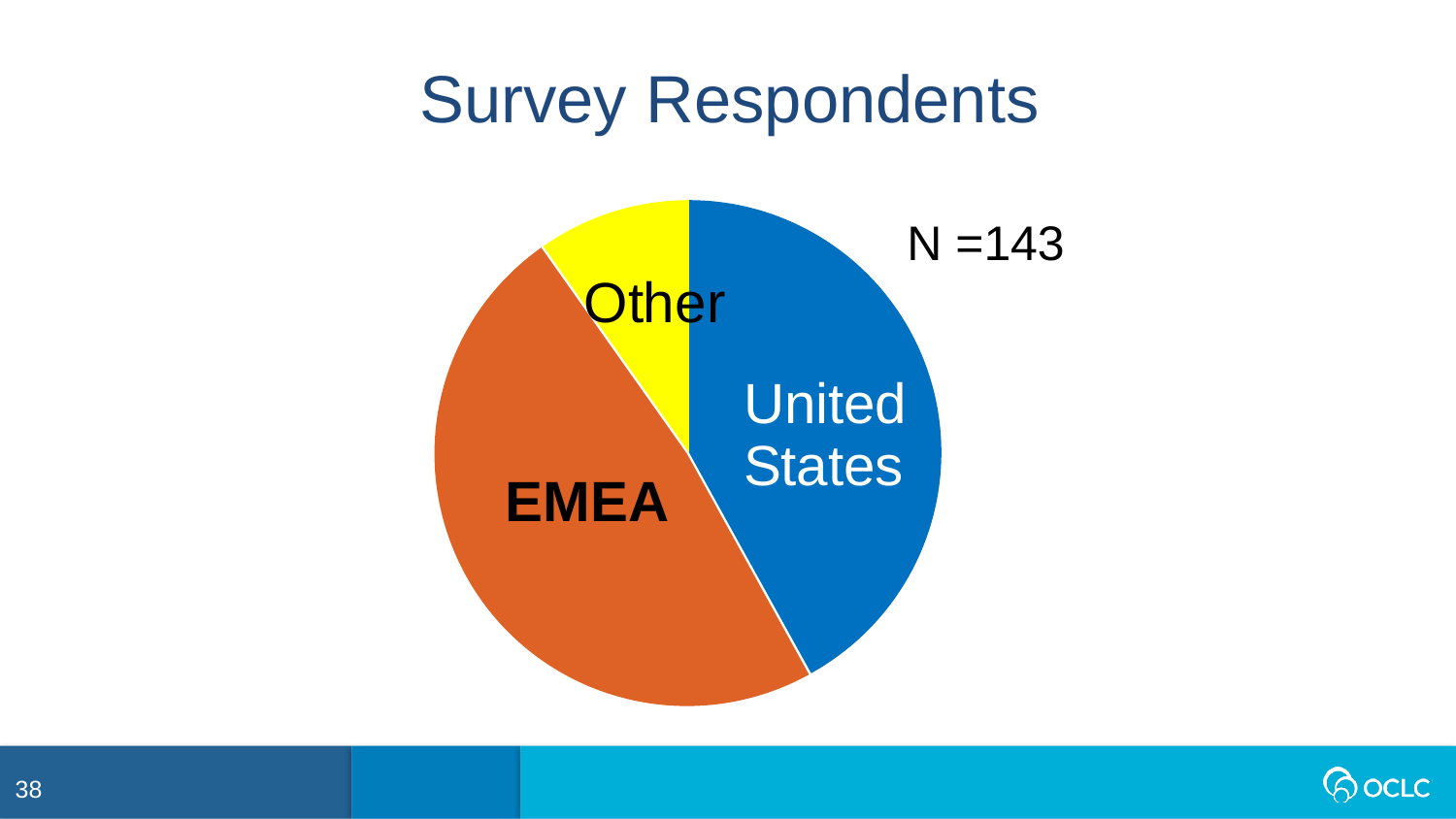
What is the total number of survey respondents (N) shown next to the pie chart? 143 Which slice is larger, EMEA or Other? EMEA Which slice is larger, United States or EMEA? EMEA What kind of chart is shown on the slide? pie chart Which slice is larger, United States or Other? United States Which category has the largest slice of the pie? EMEA What is the title of the slide containing the pie chart? Survey Respondents How many slices does the pie chart have? 3 Which category has the smallest slice of the pie? Other